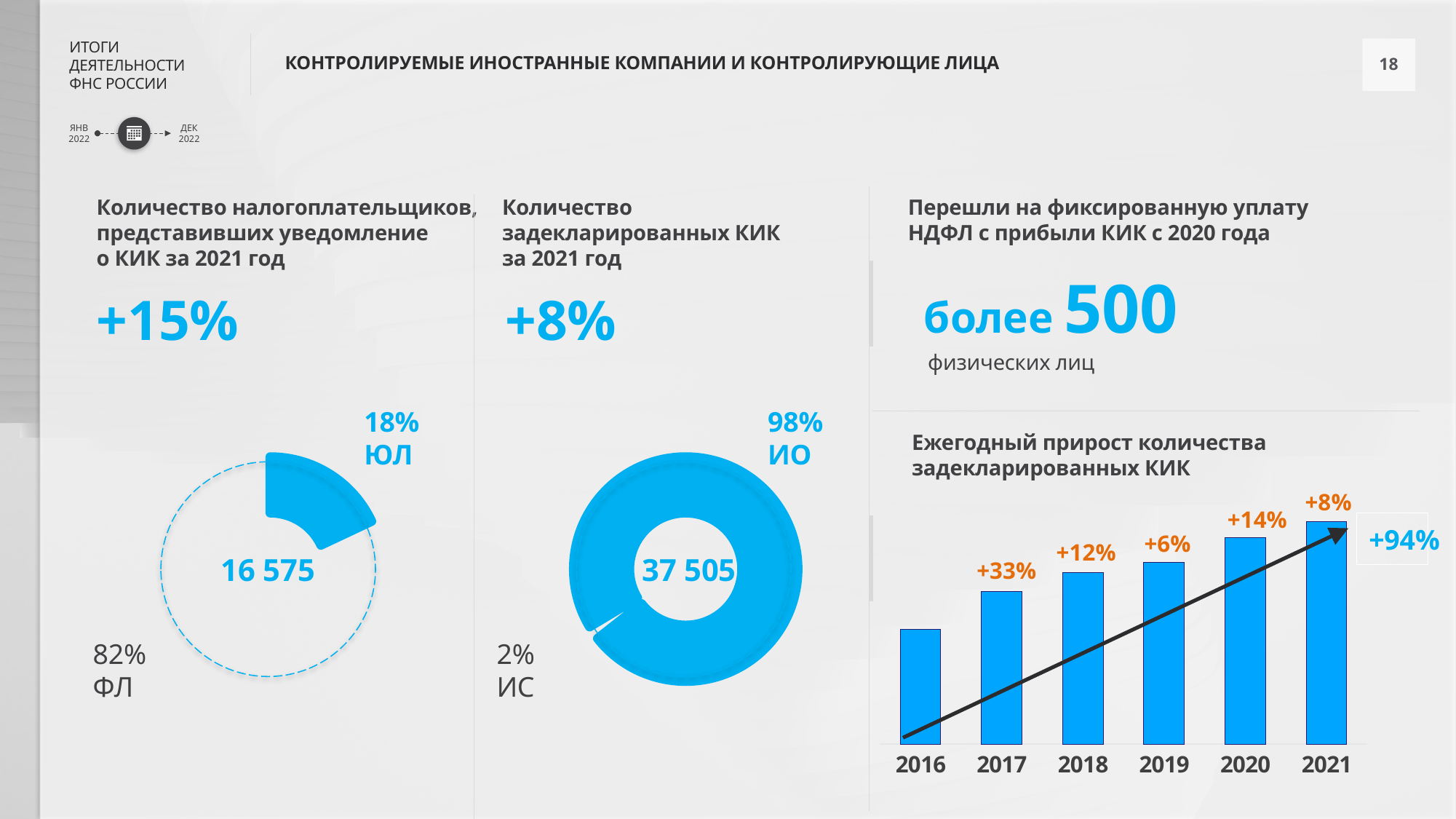
In the bar chart 'Ежегодный прирост количества задекларированных КИК', do the bars rise or fall from 2016 to 2021? rise How many years are shown on the x axis of the bar chart 'Ежегодный прирост количества задекларированных КИК'? 6 In the middle donut chart, what share is labelled ИС? 2% In the bar chart 'Ежегодный прирост количества задекларированных КИК', which year has the tallest bar? 2021 In the left donut chart, which segment is larger, ЮЛ or ФЛ? ФЛ In the left donut chart, what share is labelled ФЛ? 82% What number is shown in the centre of the left donut chart? 16 575 What number is shown in the centre of the middle donut chart? 37 505 In the bar chart 'Ежегодный прирост количества задекларированных КИК', what growth label is shown above the 2017 bar? +33% In the left donut chart titled 'Количество налогоплательщиков, представивших уведомление о КИК за 2021 год', what share is labelled ЮЛ? 18% In the middle donut chart titled 'Количество задекларированных КИК за 2021 год', what share is labelled ИО? 98% In the bar chart 'Ежегодный прирост количества задекларированных КИК', what growth label is shown above the 2020 bar? +14%